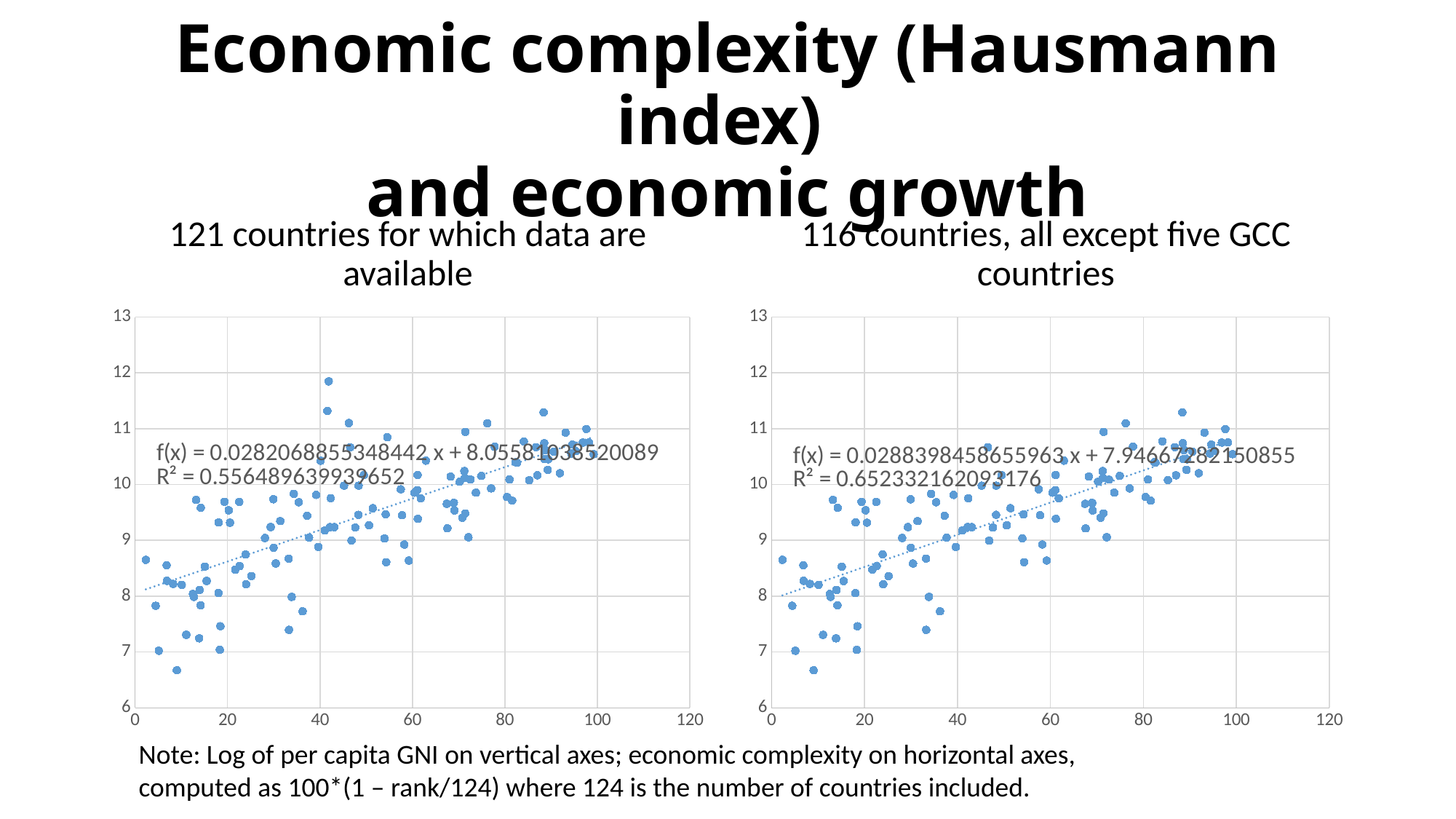
In the left chart ('121 countries for which data are available'), is the highest plotted point greater or less than 11.5 on the vertical axis? greater Which chart shows the higher R² value, the left chart (121 countries) or the right chart (116 countries)? The right chart (116 countries) In the right chart ('116 countries, all except five GCC countries'), what is the R² value printed on the chart? R² = 0.652332162093176 In the left chart ('121 countries for which data are available'), what is the maximum value shown on the horizontal axis? 120 In the left chart ('121 countries for which data are available'), do the plotted values generally rise or fall as the horizontal axis increases? Rise How many charts are shown on the slide? 2 In the right chart ('116 countries, all except five GCC countries'), what is the lowest value shown on the vertical axis? 6 In the right chart ('116 countries, all except five GCC countries'), what is the fitted trendline equation printed on the chart? f(x) = 0.0288398458655963 x + 7.94667282150855 In the left chart ('121 countries for which data are available'), is the lowest plotted point greater or less than 7 on the vertical axis? less What kind of chart is the left chart titled '121 countries for which data are available'? Scatter chart In the right chart ('116 countries, all except five GCC countries'), is the highest plotted point greater or less than 11.5 on the vertical axis? less Which chart contains a plotted point above 11.5 on the vertical axis, the left chart (121 countries) or the right chart (116 countries)? The left chart (121 countries)